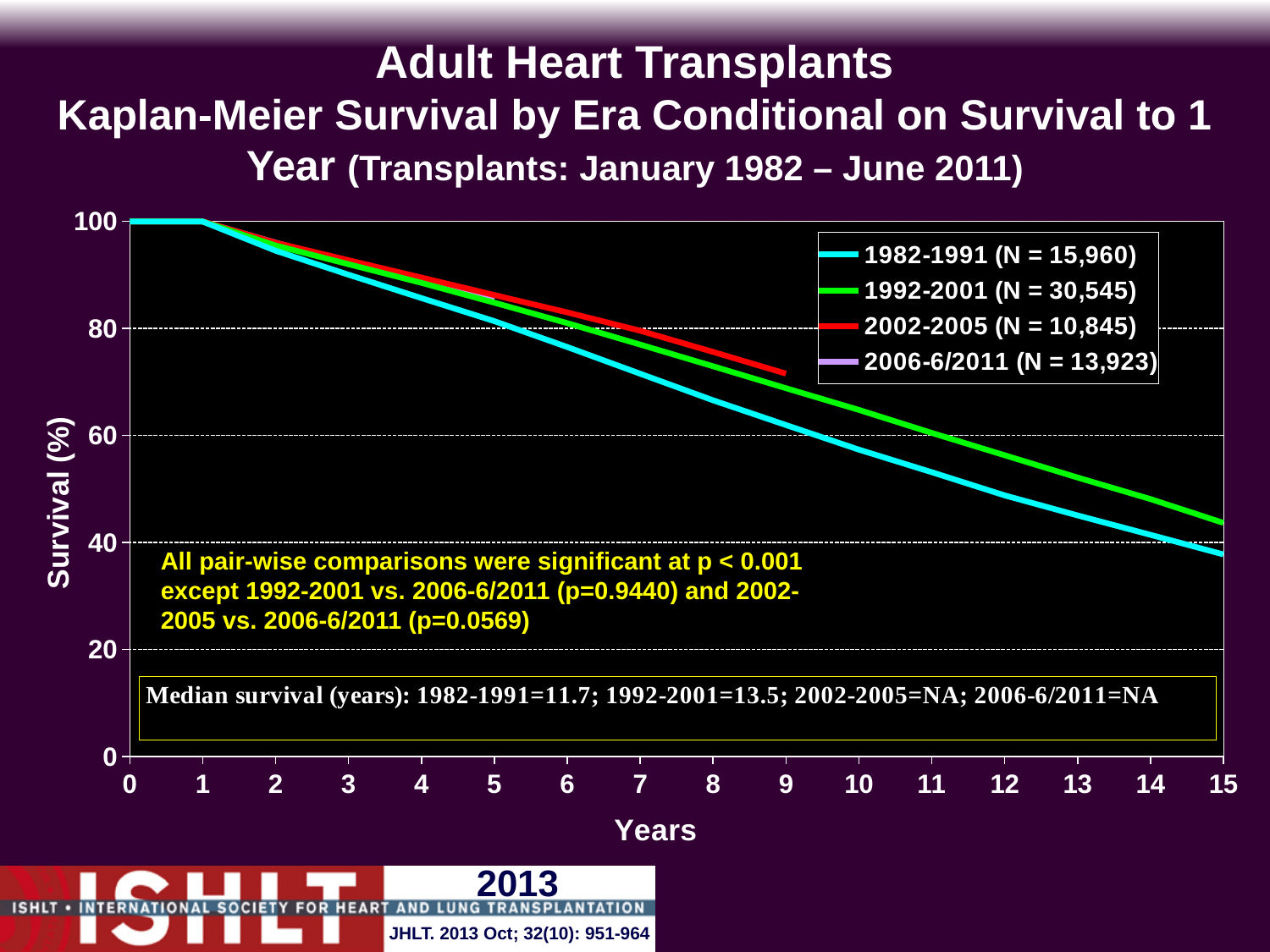
What kind of chart is shown on the slide? line chart What is the median survival in years for the 1982-1991 era? 11.7 What is the N for the 1982-1991 era shown in the legend? 15,960 At 10 years, is the survival for the 1982-1991 era greater or less than 60? less What is the difference in median survival (years) between the 1992-2001 and 1982-1991 eras? 1.8 What colour is the line for the 2002-2005 era? red Do the survival curves rise or fall as years increase? fall How many series does the legend list? 4 At 10 years, which era has higher survival, 1982-1991 or 1992-2001? 1992-2001 Which era has the largest N in the legend? 1992-2001 What is the median survival in years for the 1992-2001 era? 13.5 At 15 years, is the survival for the 1992-2001 era greater or less than 40? greater